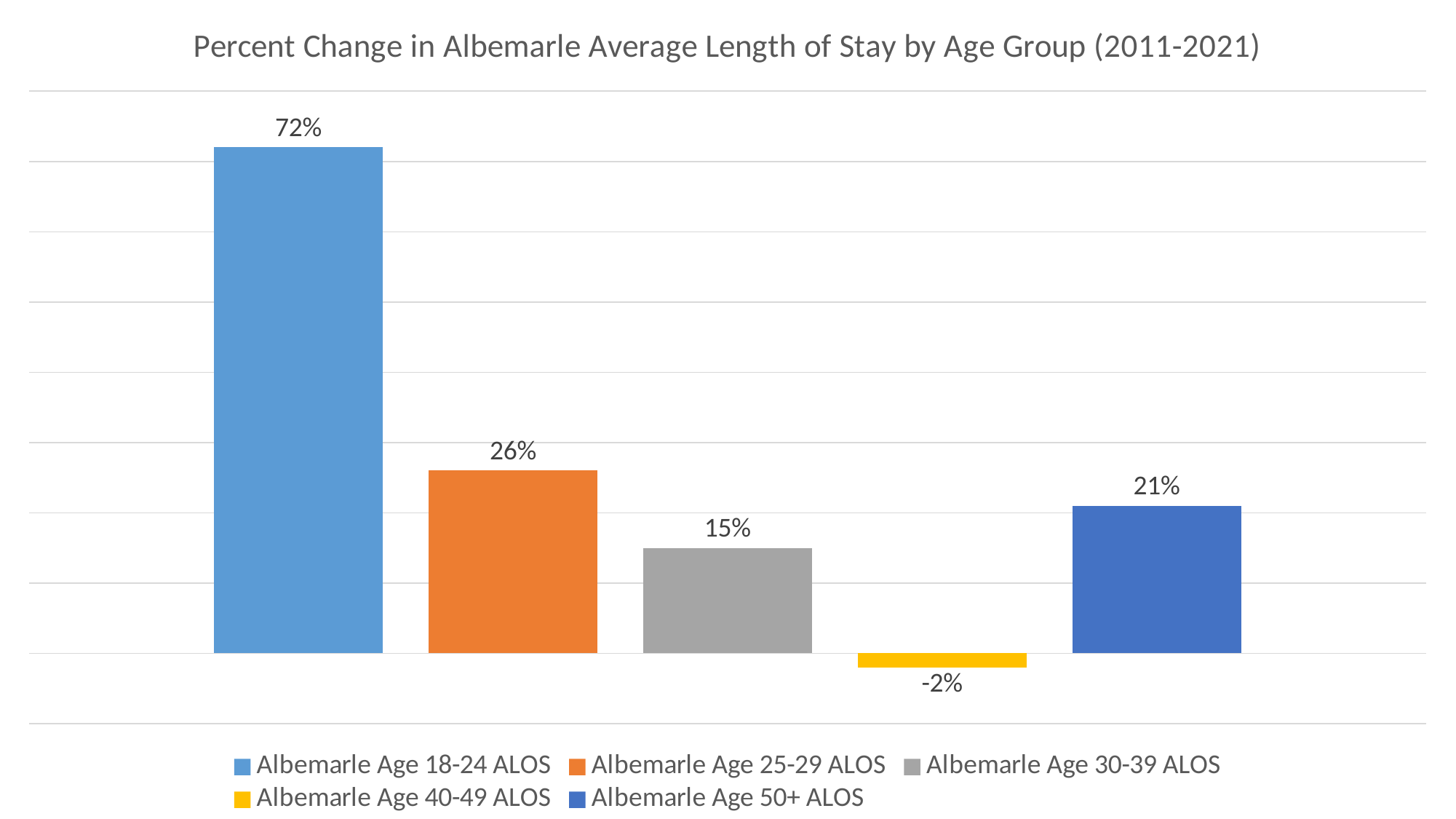
What is the percent change in average length of stay for Albemarle Age 40-49 ALOS? -2% Which age group has the lowest percent change in average length of stay? Albemarle Age 40-49 ALOS How many age groups are plotted in the chart? 5 What is the percent change in average length of stay for Albemarle Age 50+ ALOS? 21% What is the title of the chart? Percent Change in Albemarle Average Length of Stay by Age Group (2011-2021) How many entries does the legend list? 5 Which has a larger percent change: Albemarle Age 25-29 ALOS or Albemarle Age 50+ ALOS? Albemarle Age 25-29 ALOS What is the percent change in average length of stay for Albemarle Age 18-24 ALOS? 72% Which age group has the highest percent change in average length of stay? Albemarle Age 18-24 ALOS What is the difference between the percent change for Albemarle Age 50+ ALOS and Albemarle Age 30-39 ALOS? 6% What kind of chart is shown on the slide? Bar chart What is the difference between the percent change for Albemarle Age 18-24 ALOS and Albemarle Age 25-29 ALOS? 46%